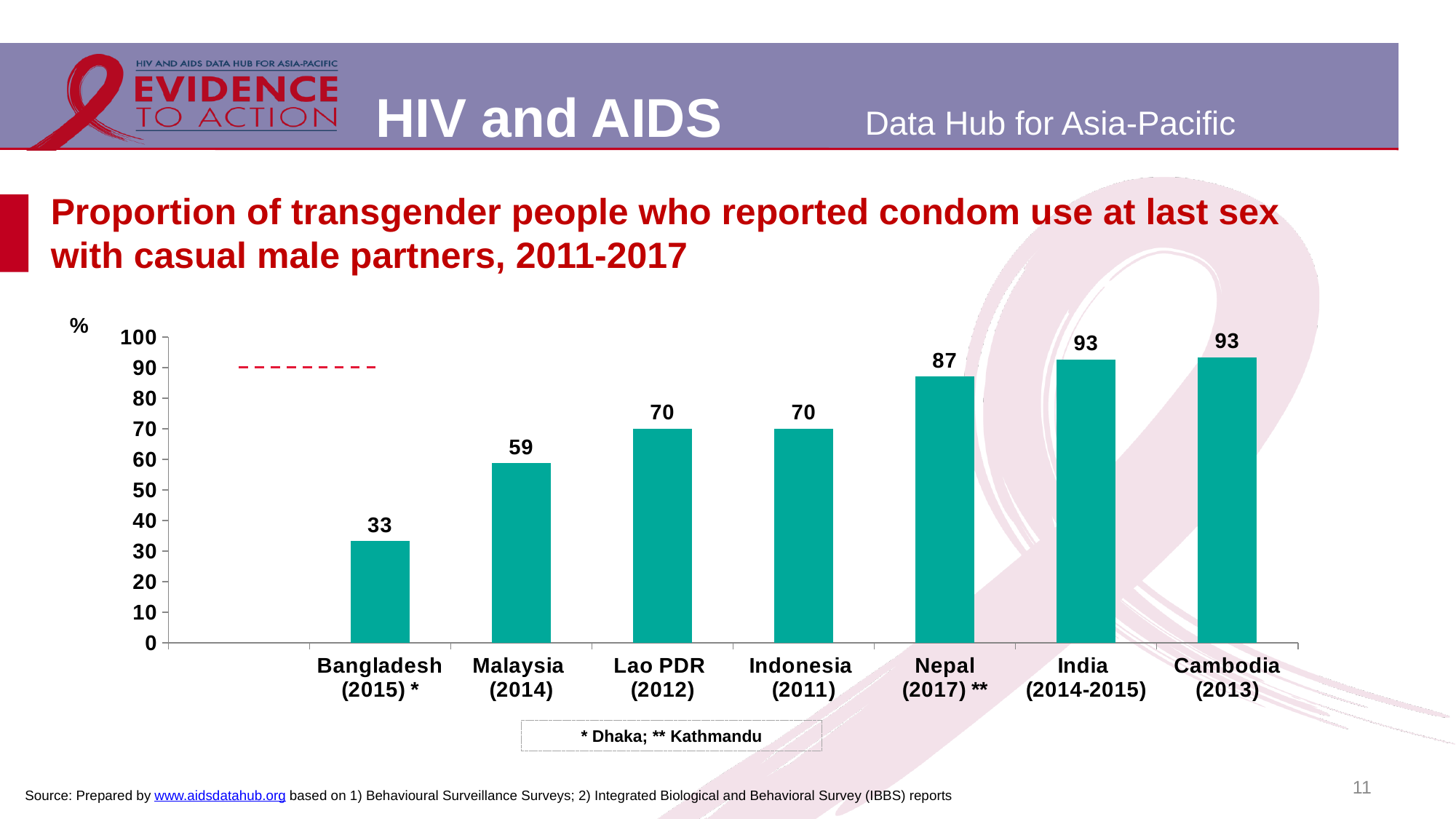
What is the difference between the values for Cambodia (2013) and Bangladesh (2015)? 60 What is the value for Malaysia (2014)? 59 What is the value for Bangladesh (2015)? 33 What unit is shown on the y axis of the chart? % How many countries are shown in the chart? 7 What kind of chart is shown on the slide? bar chart Do the values generally rise or fall from left to right across the chart? rise What is the difference between the values for Nepal (2017) and Malaysia (2014)? 28 Which country has the lowest proportion of transgender people reporting condom use at last sex with casual male partners? Bangladesh (2015) Is the value for Indonesia (2011) greater or less than 60? greater What is the value for Nepal (2017)? 87 Which is larger, the value for Lao PDR (2012) or the value for Malaysia (2014)? Lao PDR (2012)